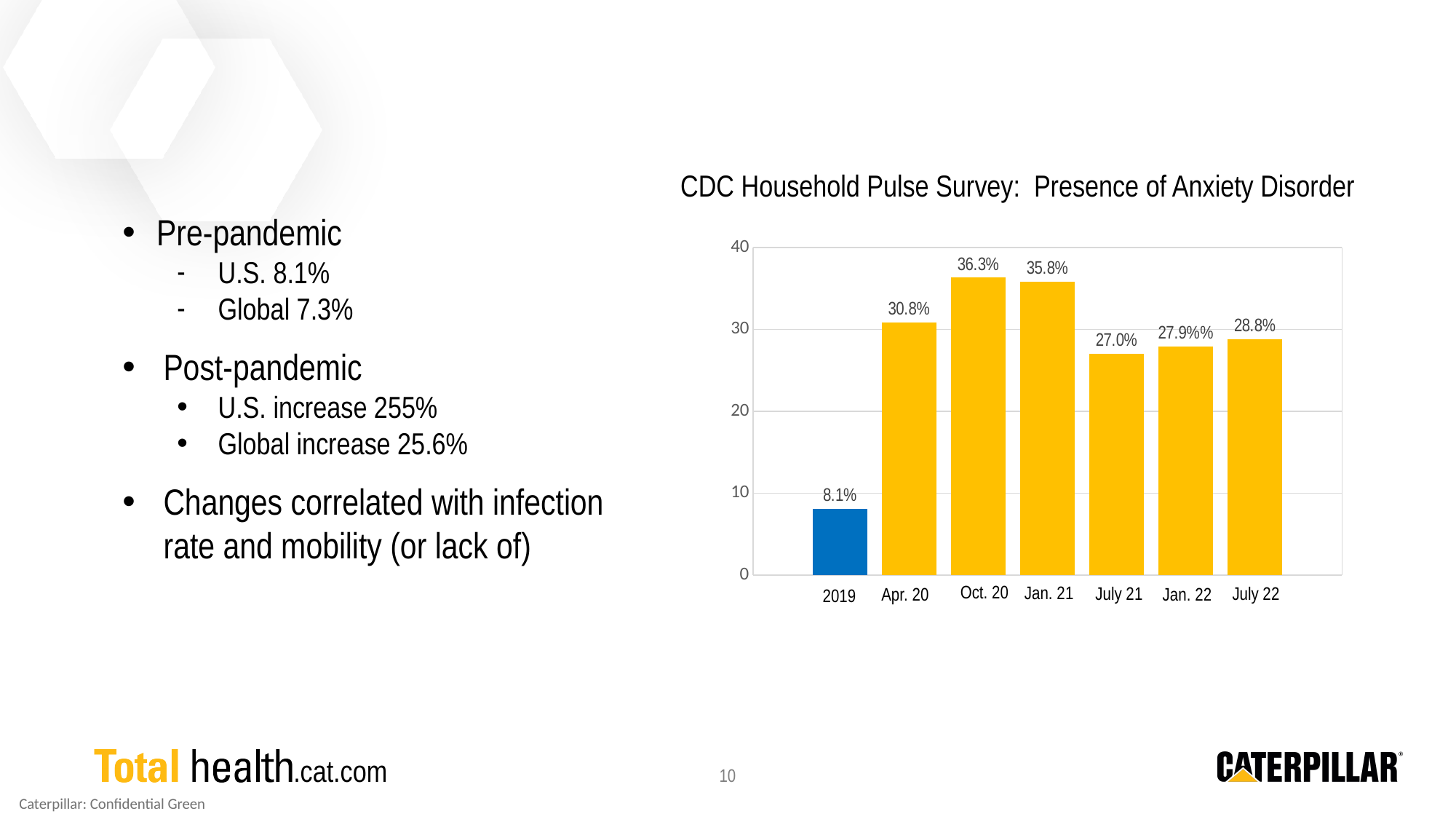
What is the value for Oct. 20? 36.3% Is the value for July 21 greater or less than 30? less How many periods are shown on the x axis? 7 Which period has the highest value? Oct. 20 What kind of chart is shown on the slide? bar chart What is the value for July 22? 28.8% What is the value for 2019 in the CDC Household Pulse Survey chart? 8.1% Which is larger, the value for Apr. 20 or the value for July 22? Apr. 20 Which period has the lowest value? 2019 What is the value for Jan. 21? 35.8% What is the difference between the values for Jan. 21 and July 21? 8.8% What is the difference between the values for Oct. 20 and Apr. 20? 5.5%